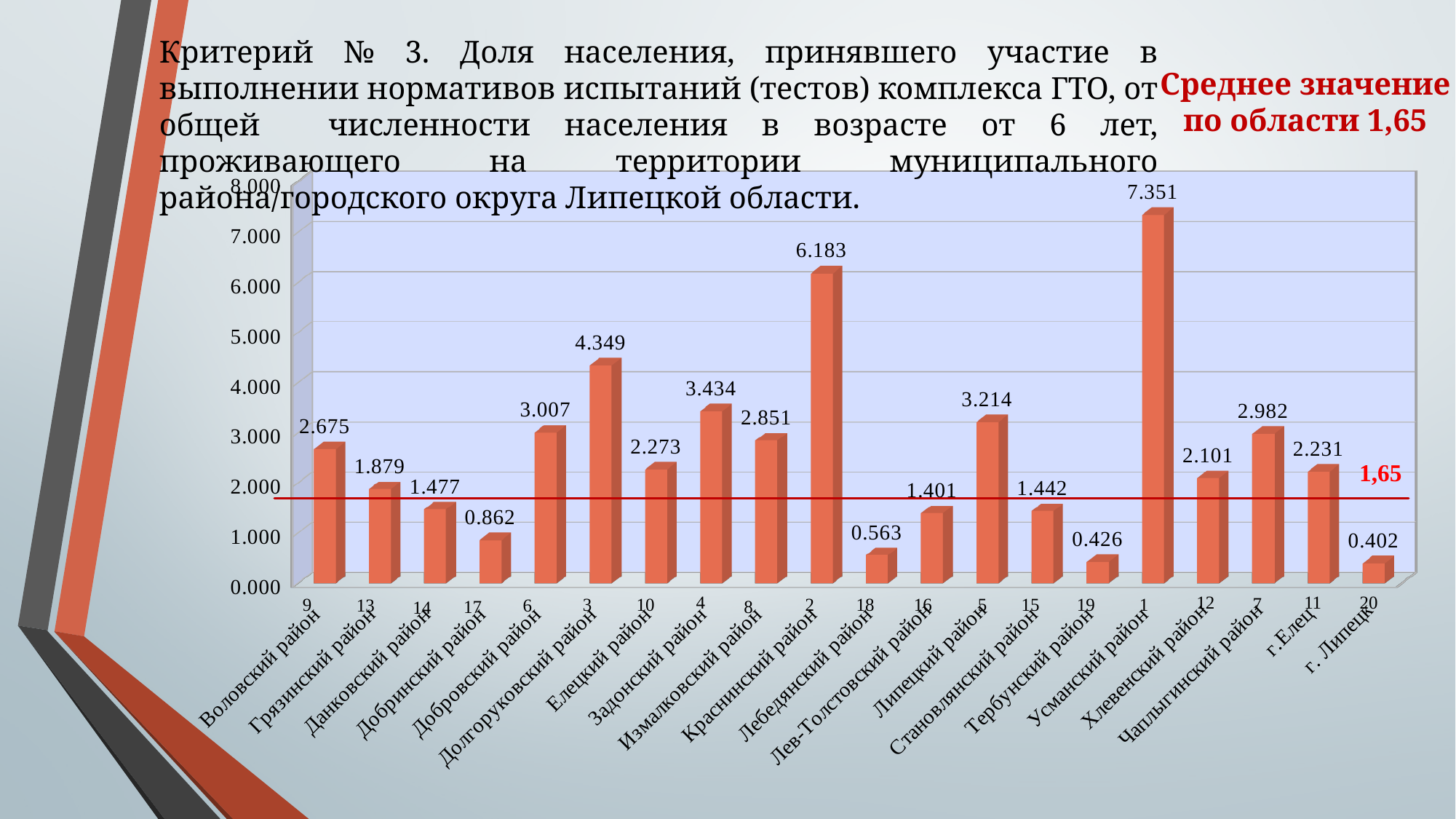
What is the value for Усманский район? 7.351 What kind of chart is shown on the slide? Bar chart What is the value for г. Липецк? 0.402 What is the value for Краснинский район? 6.183 What is the value for Долгоруковский район? 4.349 Which category has the highest value? Усманский район What is the difference between the values for Усманский район and Краснинский район? 1.168 What value does the red horizontal line on the chart mark? 1,65 Which is larger, the value for Задонский район or the value for Липецкий район? Задонский район Which category has the lowest value? г. Липецк What is the difference between the values for Чаплыгинский район and г.Елец? 0.751 How many categories are shown on the x axis? 20